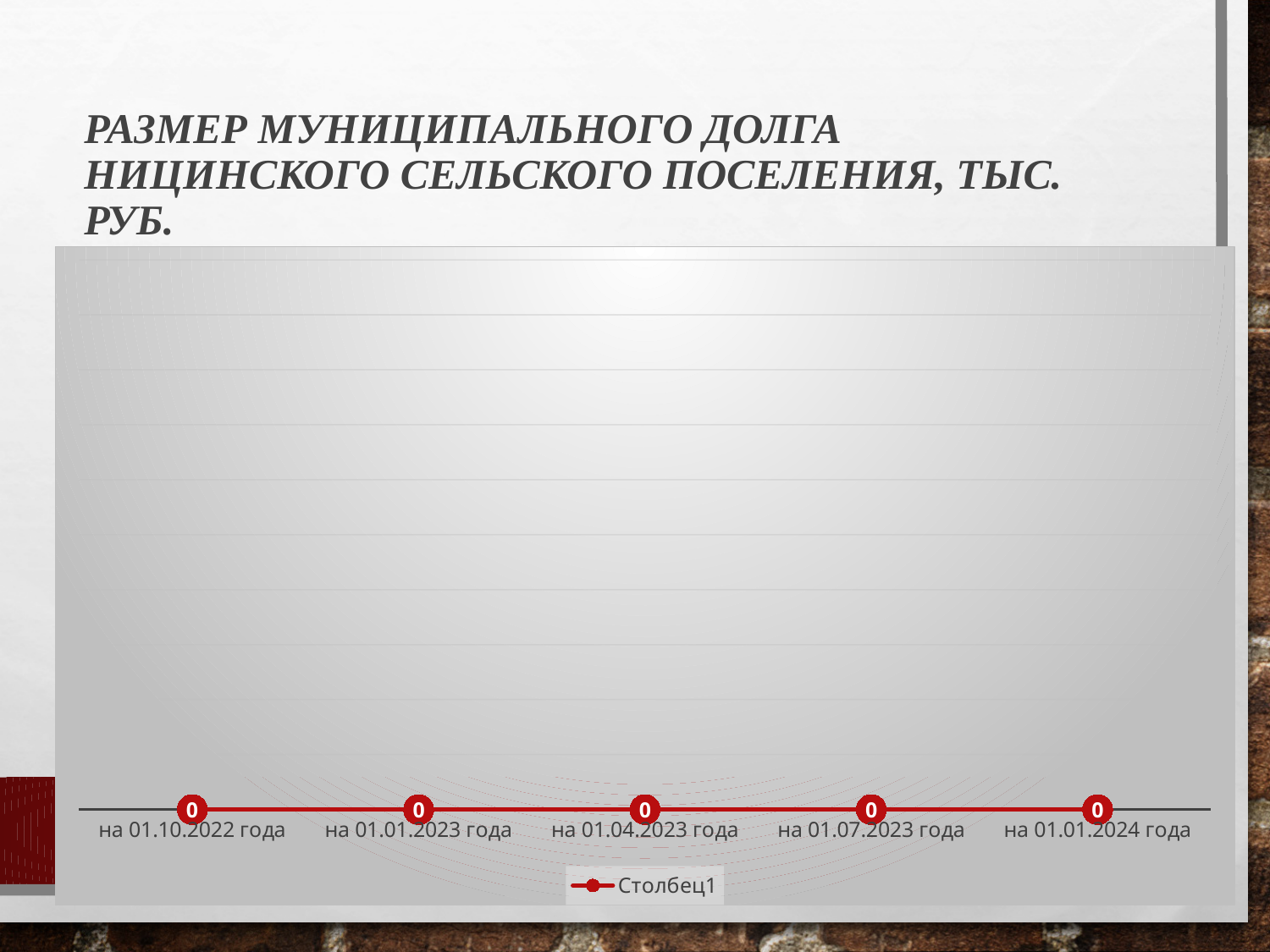
What kind of chart is shown on the slide? line chart How many data points are plotted on the chart? 5 What is the difference between the values for на 01.01.2024 года and на 01.10.2022 года? 0 What is the value for на 01.04.2023 года? 0 What is the name of the series shown in the legend? Столбец1 What is the value for на 01.01.2023 года? 0 Do the values rise, fall or stay the same from на 01.10.2022 года to на 01.01.2024 года? stay the same In what units does the chart title say the municipal debt is measured? тыс. руб. What is the value for на 01.10.2022 года? 0 How many series does the legend list? 1 What is the value for на 01.07.2023 года? 0 What is the value for на 01.01.2024 года? 0